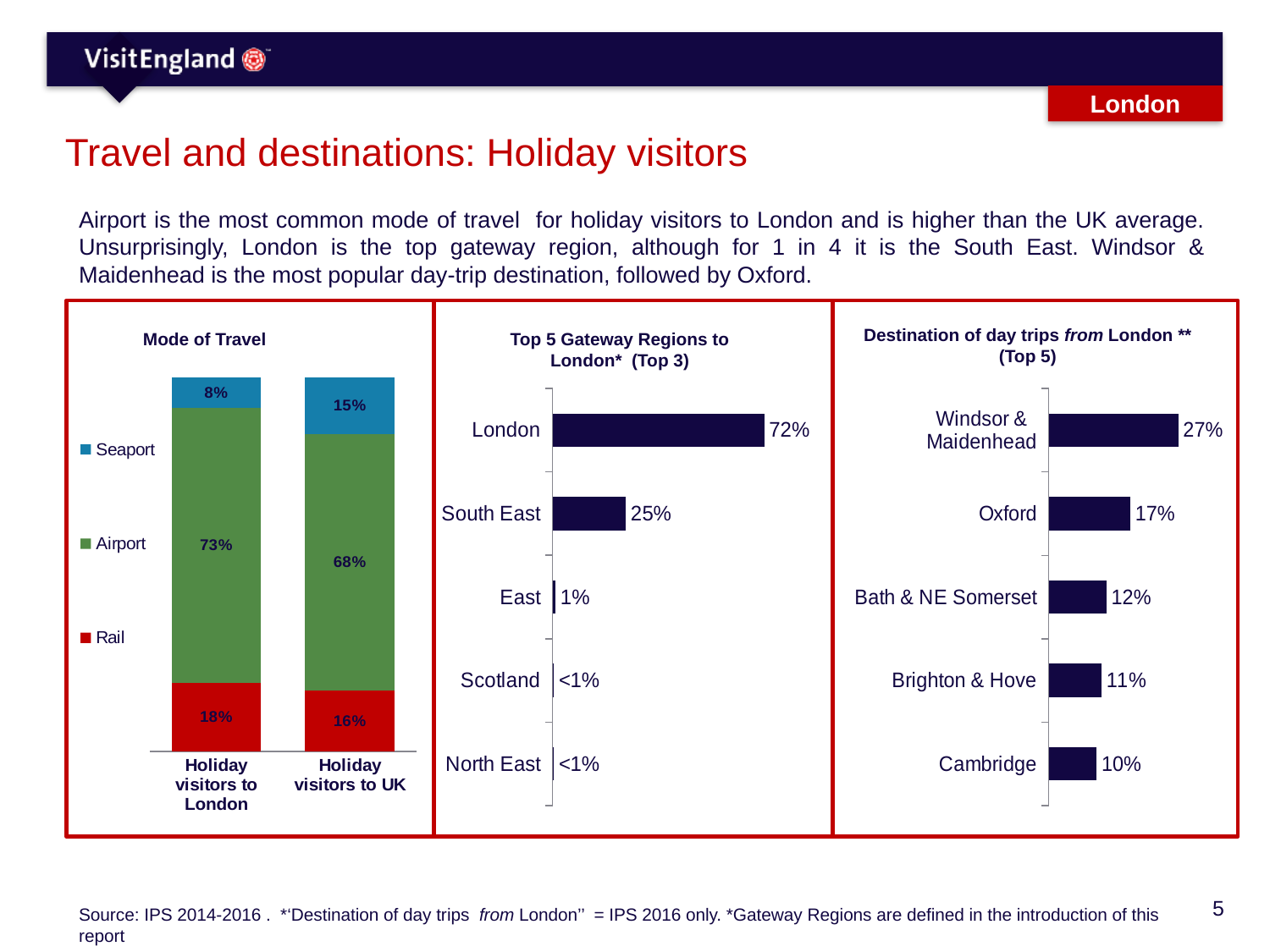
In the Top 5 Gateway Regions to London chart, how many regions are shown? 5 In the Mode of Travel chart, which is larger: the Airport share for holiday visitors to London or for holiday visitors to UK? Holiday visitors to London In the Destination of day trips from London chart, what is the value for Bath & NE Somerset? 12% In the Mode of Travel chart, what is the difference between the Rail share for holiday visitors to London and for holiday visitors to the UK? 2% In the Mode of Travel chart, what is the Seaport share for holiday visitors to the UK? 15% In the Top 5 Gateway Regions to London chart, which region has the highest value? London In the Mode of Travel chart, how many series does the legend list? 3 In the Top 5 Gateway Regions to London chart, what is the difference between London and South East? 47% In the Mode of Travel chart, what percentage of holiday visitors to London travelled by airport? 73% What kind of chart is the Destination of day trips from London chart? Bar chart In the Destination of day trips from London chart, which destination has the lowest value? Cambridge In the Top 5 Gateway Regions to London chart, what is the value for South East? 25%